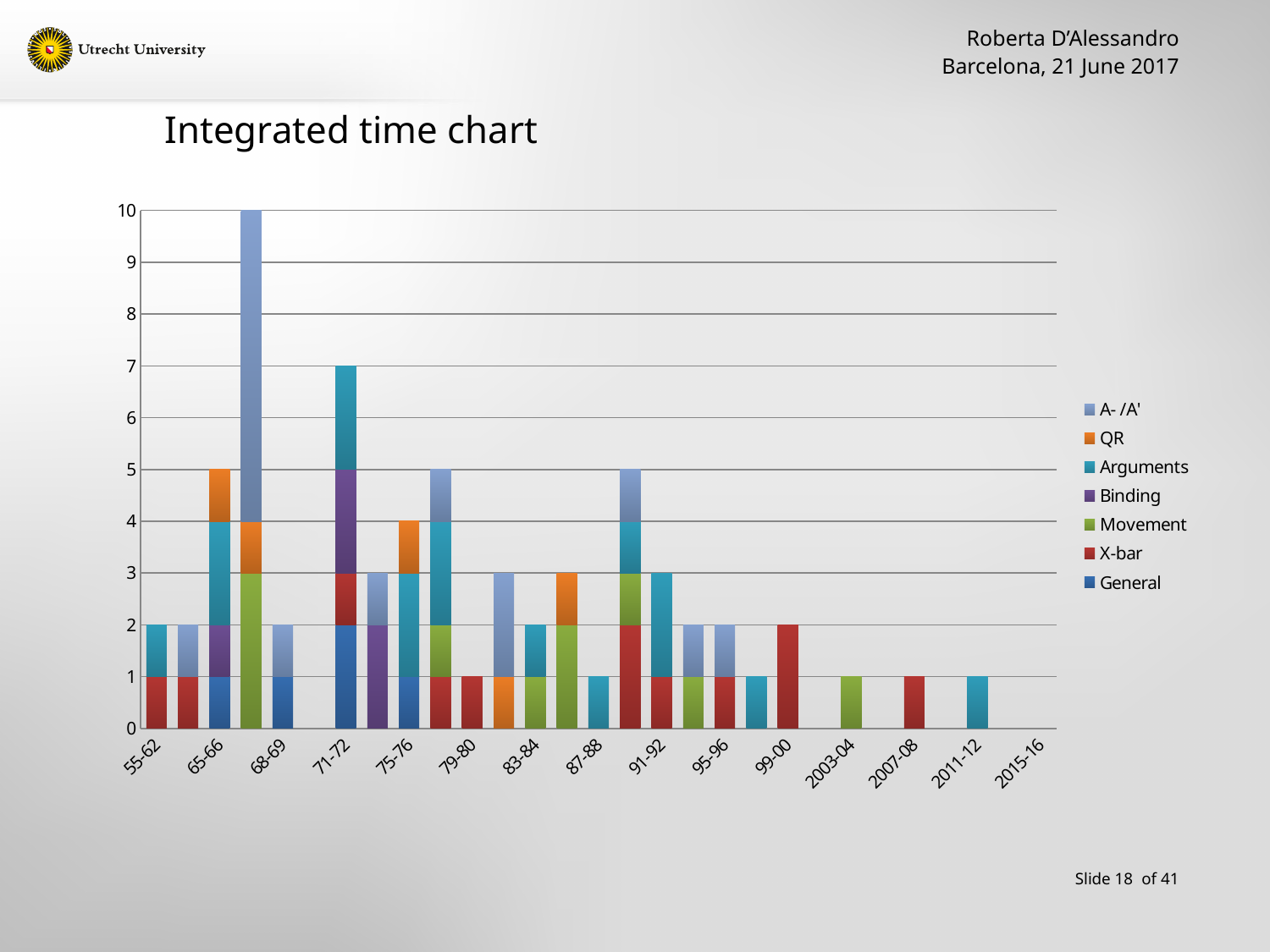
What is the title of the chart? Integrated time chart What is the value of Arguments for 2011-12? 1 Is the total for 71-72 greater or less than 5? greater What is the total height of the stacked bar for 71-72? 7 What is the value of X-bar for 99-00? 2 What is the value of Movement for 2003-04? 1 What is the difference between the stacked totals for 71-72 and 75-76? 3 Which has a taller stacked bar, 71-72 or 75-76? 71-72 How many series does the legend list? 7 What kind of chart is shown on the slide? Stacked bar chart Do the stacked totals generally rise or fall from 71-72 to 2015-16? fall What is the total height of the stacked bar for 65-66? 5